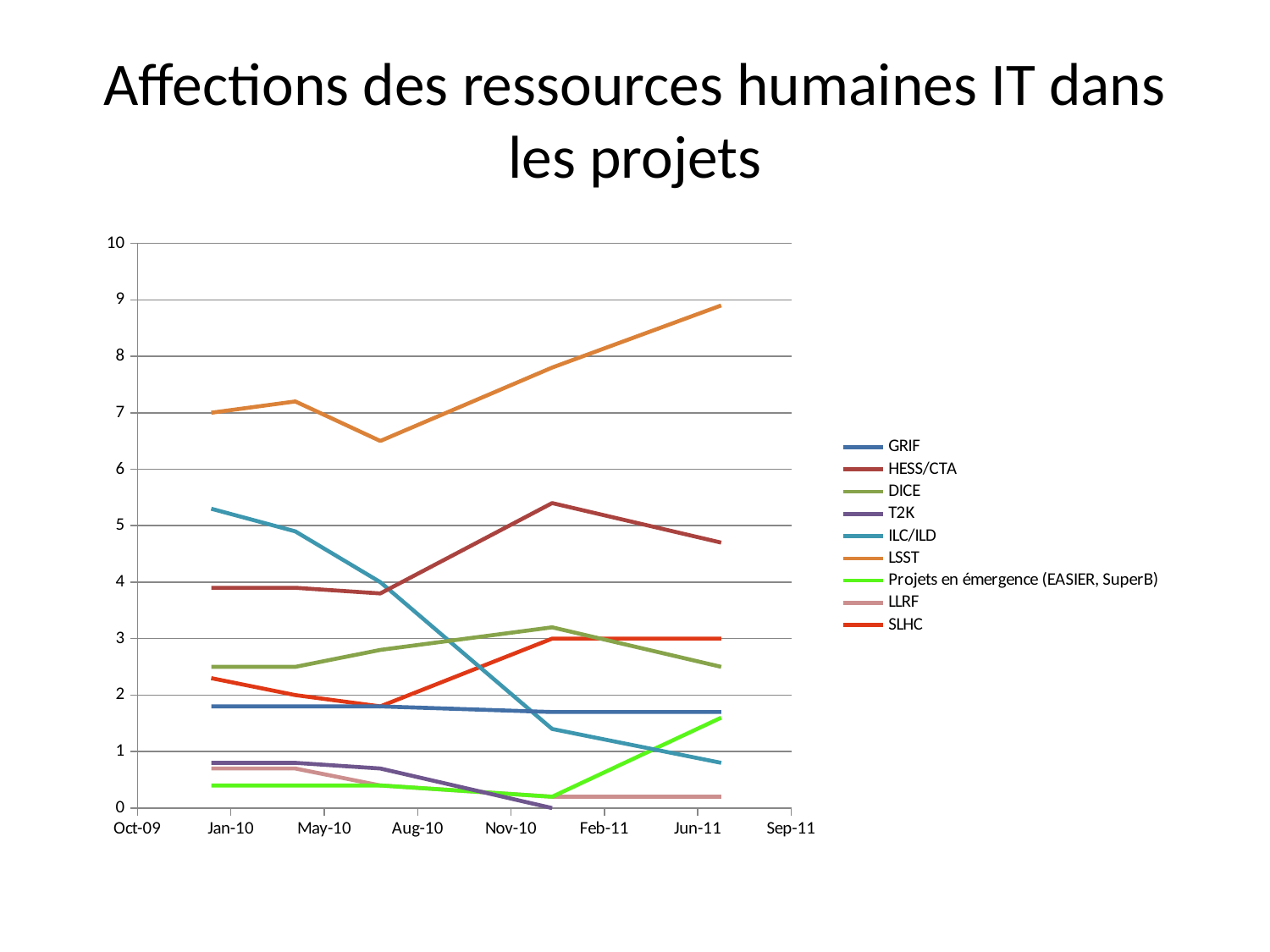
Is the value for GRIF at Jun-11 greater or less than 2? less What kind of chart is shown on the slide? line chart Is the value for LSST at Jun-11 greater or less than 8? greater Does the LSST line rise or fall overall from Jan-10 to Jun-11? rise How many series does the legend list? 9 What is the title of the slide's chart? Affections des ressources humaines IT dans les projets Which series has the highest value at Jun-11? LSST Does the ILC/ILD line rise or fall overall from Jan-10 to Jun-11? fall Is the highest point of the HESS/CTA line greater or less than 5? greater At Jan-10, which is larger: ILC/ILD or HESS/CTA? ILC/ILD What colour is the LSST line in the legend? orange